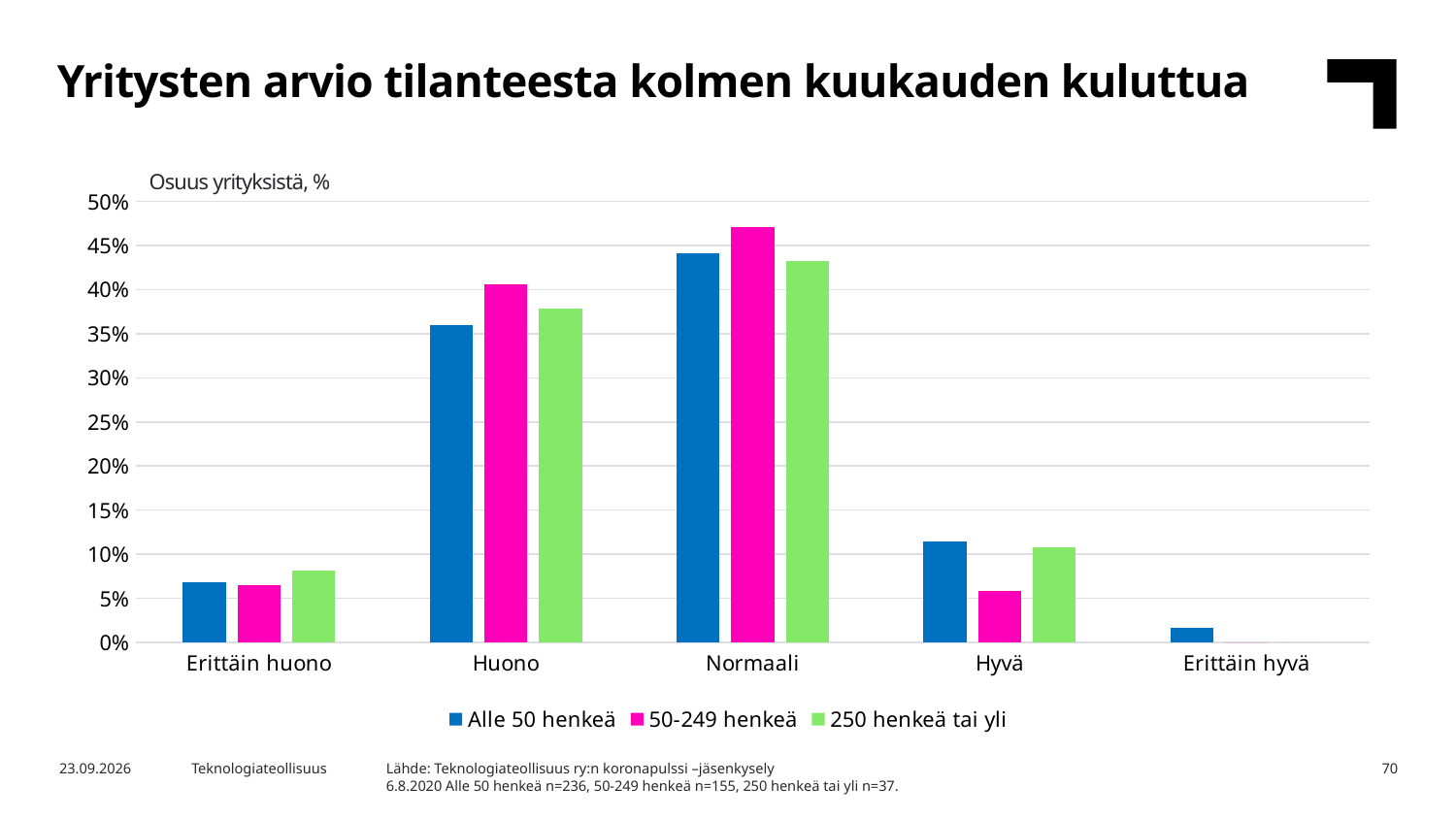
How many categories are shown on the x axis? 5 In the Hyvä category, which is larger: Alle 50 henkeä or 50-249 henkeä? Alle 50 henkeä Is the value for Alle 50 henkeä in the Huono category greater or less than 30%? greater For the series 50-249 henkeä, which category has the highest value? Normaali What is the title of the slide? Yritysten arvio tilanteesta kolmen kuukauden kuluttua What kind of chart is shown on the slide? bar chart Is the value for 50-249 henkeä in the Normaali category greater or less than 40%? greater For the series Alle 50 henkeä, which category has the lowest value? Erittäin hyvä How many series does the legend list? 3 Is the value for 250 henkeä tai yli in the Erittäin huono category greater or less than 10%? less What label is shown above the vertical axis of the chart? Osuus yrityksistä, % In the Huono category, which is larger: Alle 50 henkeä or 50-249 henkeä? 50-249 henkeä